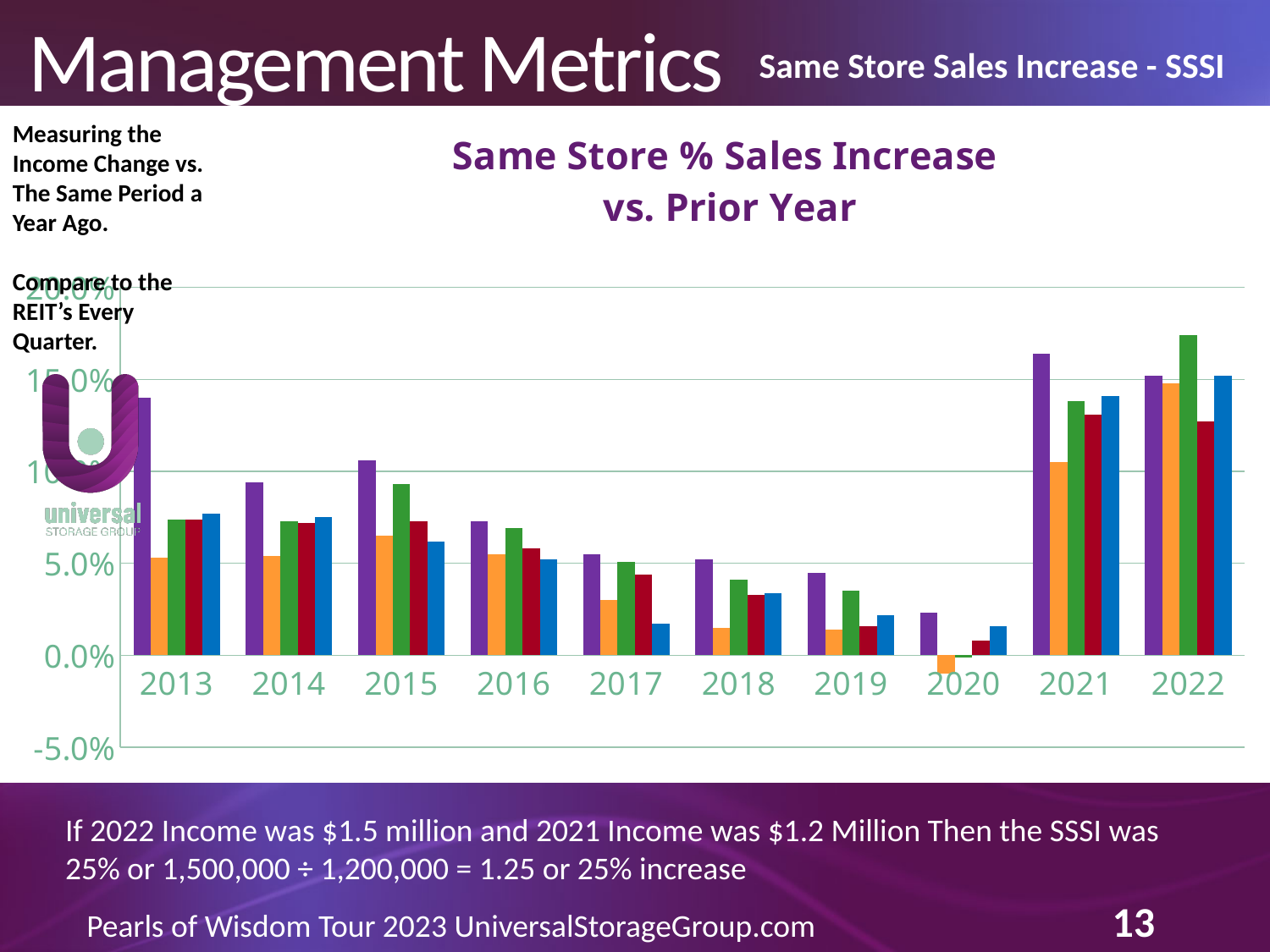
Is the value of the purple bar for 2020 greater or less than 5.0%? less What is the title of the chart? Same Store % Sales Increase vs. Prior Year Which is larger, the purple bar for 2021 or the purple bar for 2020? 2021 Do the purple bars rise or fall from 2015 through 2020? fall Is the value of the purple bar for 2021 greater or less than 15.0%? greater Which year contains the only bar that falls below 0.0%? 2020 What kind of chart is shown on the slide? bar chart What is the highest value labelled on the vertical axis of the chart? 20.0% How many years are shown along the x axis of the chart? 10 Is the value of the orange bar for 2020 greater or less than 0.0%? less How many bars are plotted for each year in the chart? 5